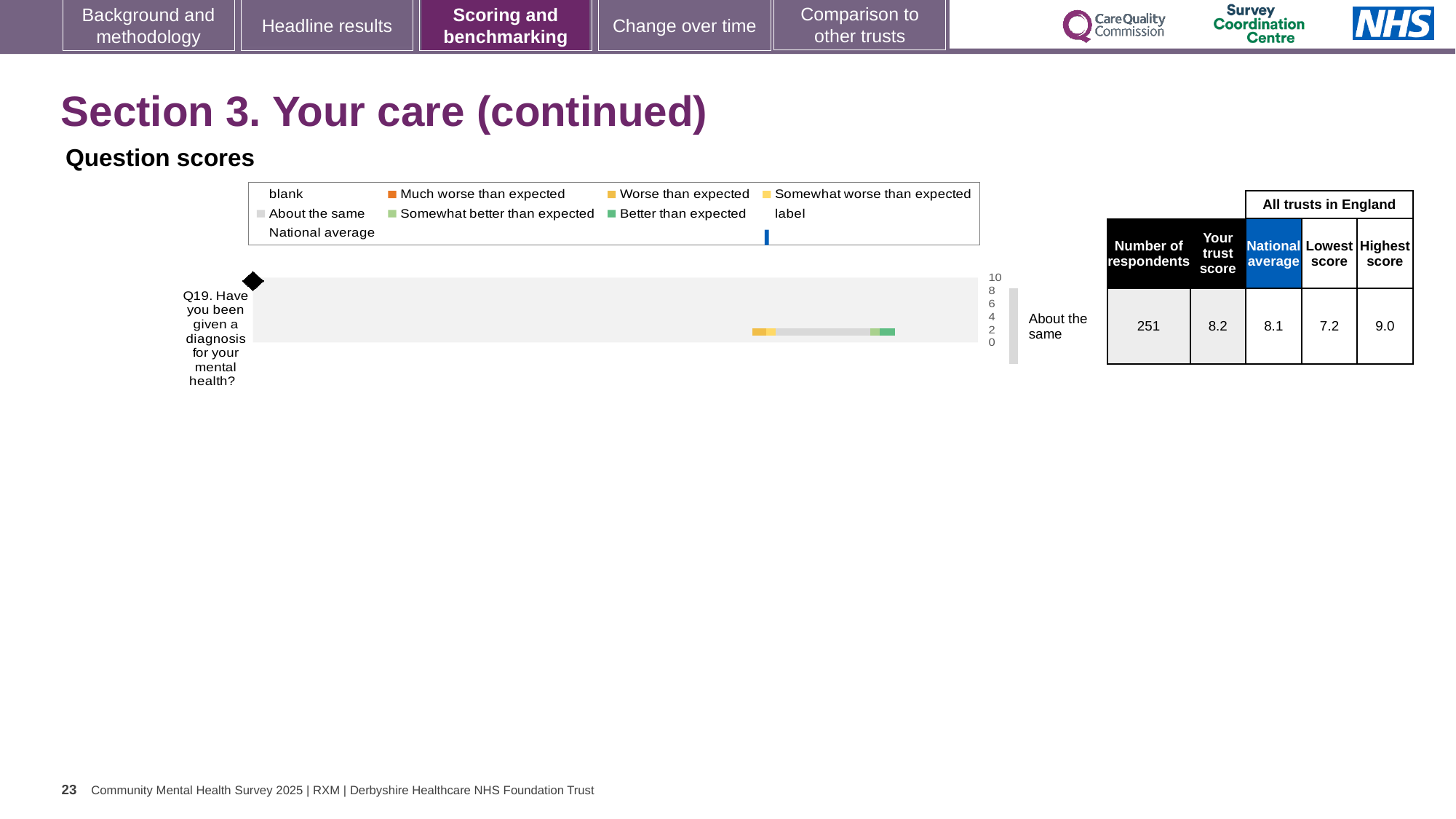
What is the highest score among all trusts in England for Q19? 9.0 What is the benchmark category shown for Q19? About the same What is the national average for Q19? 8.1 What is the difference between the highest score and the lowest score for Q19? 1.8 What is the lowest score among all trusts in England for Q19? 7.2 How many questions are plotted in the Question scores chart? 1 What is the difference between the trust score and the national average for Q19? 0.1 Which question is plotted in the Question scores chart? Q19. Have you been given a diagnosis for your mental health? What is the trust score for Q19? 8.2 What is the number of respondents for Q19? 251 What kind of chart is shown under 'Question scores'? bar chart Which is larger for Q19, the trust score or the national average? trust score